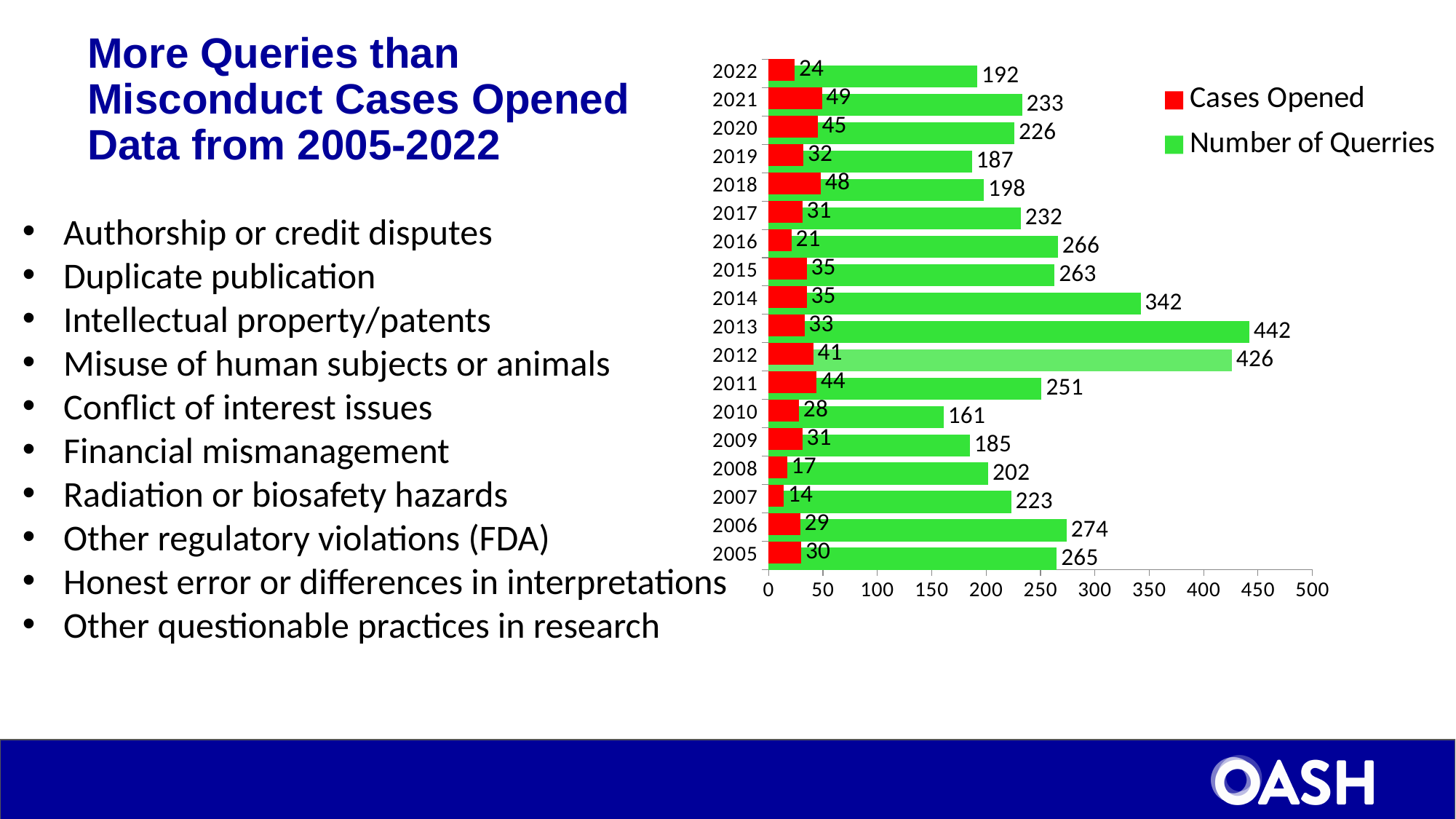
Which colour represents Cases Opened in the chart? red Which year has the highest Number of Querries? 2013 Which year had more Cases Opened, 2018 or 2016? 2018 What kind of chart is shown on the slide? bar chart What is the Number of Querries value for 2013? 442 How many Cases Opened are shown for 2021? 49 Is the Number of Querries for 2014 greater or less than 300? greater How many series does the legend list? 2 Which year has the lowest Number of Querries? 2010 Which year has the fewest Cases Opened? 2007 What is the difference between the Number of Querries in 2013 and in 2012? 16 How many years are shown on the chart? 18